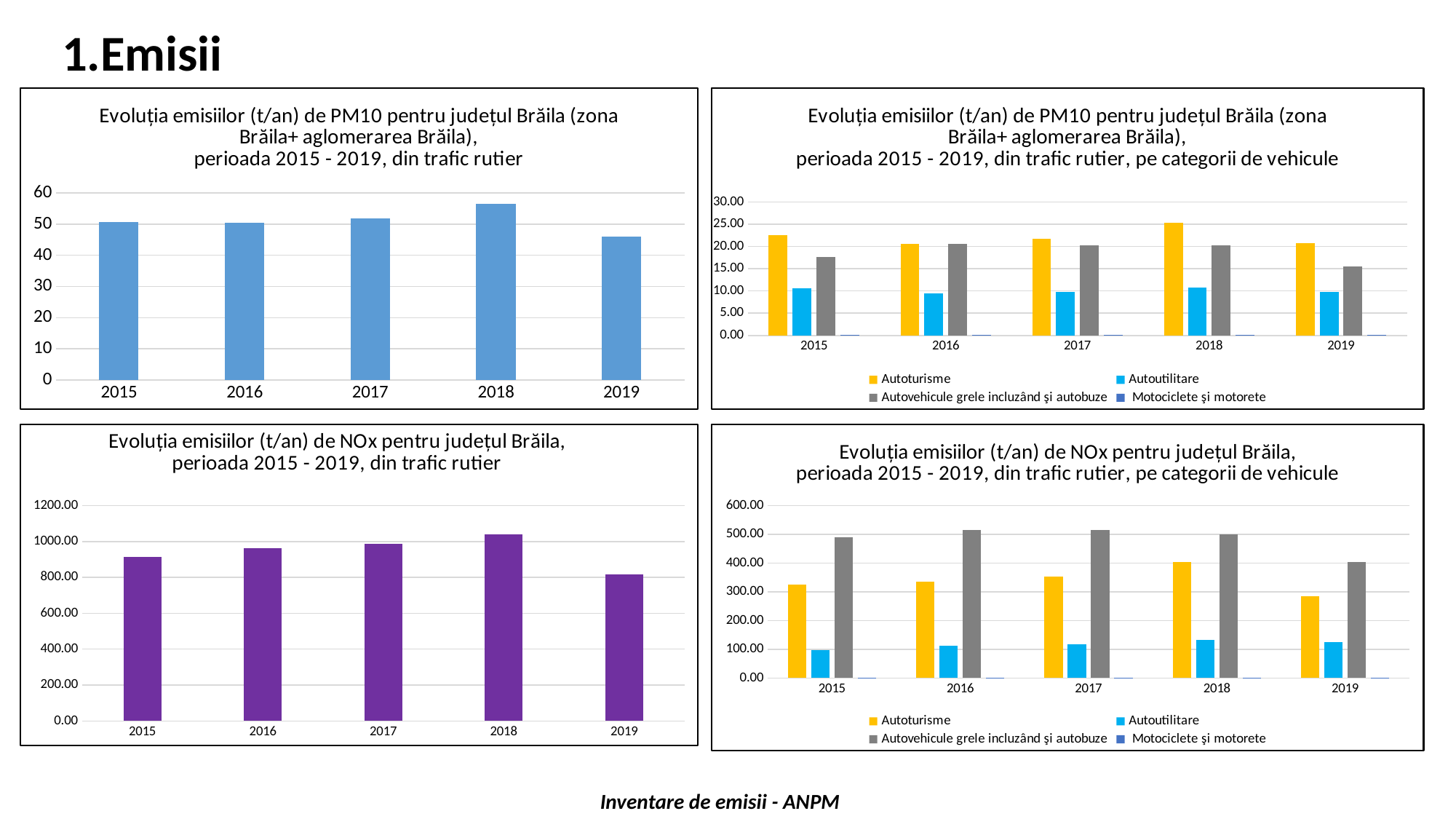
In the top-left chart (PM10 emissions, 2015-2019, road traffic), which year has the lowest value? 2019 In the bottom-left chart (NOx emissions, 2015-2019, road traffic), which year has the highest value? 2018 In the top-left chart (PM10 emissions, 2015-2019, road traffic), which year has the highest value? 2018 What type of chart is the bottom-left chart (NOx emissions, 2015-2019, road traffic)? bar chart In the top-left chart (PM10 emissions, road traffic), how many years are plotted? 5 In the bottom-left chart (NOx emissions, road traffic), is the value for 2018 greater or less than 1000.00? greater In the top-right chart (PM10 emissions by vehicle category), in which year is the Autoturisme value highest? 2018 In the top-right chart (PM10 emissions by vehicle category), how many series does the legend list? 4 In the top-left chart (PM10 emissions, road traffic), is the value for 2019 greater or less than 50? less In the top-right chart (PM10 emissions by vehicle category), is the Autoturisme value for 2015 greater or less than 20.00? greater In the bottom-right chart (NOx emissions by vehicle category), which is larger in 2017: Autoturisme or Autovehicule grele incluzând și autobuze? Autovehicule grele incluzând și autobuze